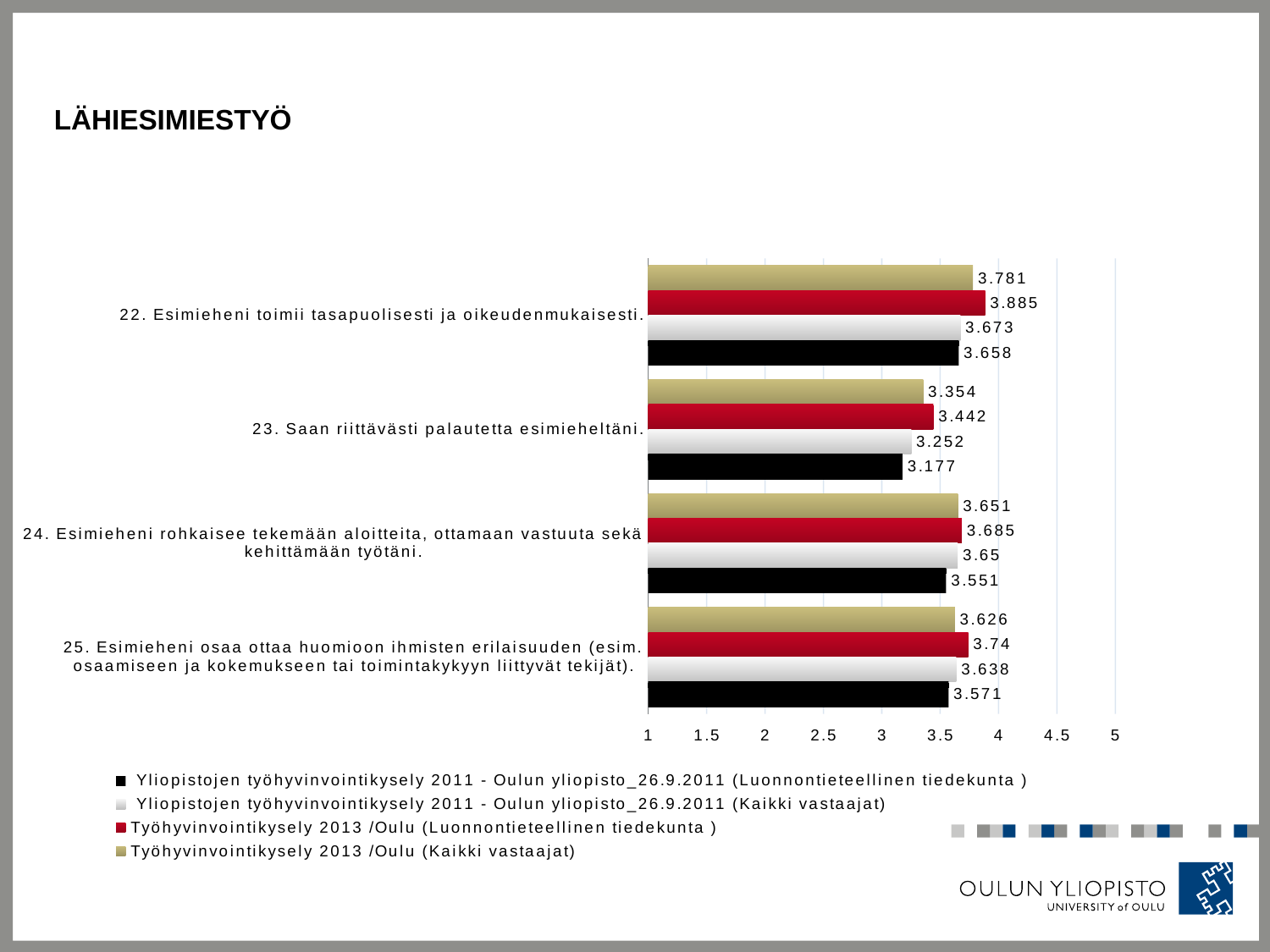
How many series does the legend list? 4 For question 25, which is larger: the Työhyvinvointikysely 2013 /Oulu (Luonnontieteellinen tiedekunta) value or the Yliopistojen työhyvinvointikysely 2011 (Kaikki vastaajat) value? Työhyvinvointikysely 2013 /Oulu (Luonnontieteellinen tiedekunta) What is the value for question 23 in the Yliopistojen työhyvinvointikysely 2011 (Luonnontieteellinen tiedekunta) series? 3.177 Which question has the highest value in the Työhyvinvointikysely 2013 /Oulu (Luonnontieteellinen tiedekunta) series? 22. Esimieheni toimii tasapuolisesti ja oikeudenmukaisesti. What is the value for question 25 in the Työhyvinvointikysely 2013 /Oulu (Kaikki vastaajat) series? 3.626 What is the value for question 22 in the Työhyvinvointikysely 2013 /Oulu (Luonnontieteellinen tiedekunta) series? 3.885 What is the difference between the 2013 Luonnontieteellinen tiedekunta value and the 2011 Luonnontieteellinen tiedekunta value for question 23? 0.265 What is the value for question 24 in the Yliopistojen työhyvinvointikysely 2011 (Kaikki vastaajat) series? 3.65 Which question has the lowest value in the Yliopistojen työhyvinvointikysely 2011 (Luonnontieteellinen tiedekunta) series? 23. Saan riittävästi palautetta esimieheltäni. How many questions (categories) are shown on the chart? 4 What kind of chart is shown on the slide? bar chart Is the value for question 23 in the Yliopistojen työhyvinvointikysely 2011 (Kaikki vastaajat) series greater or less than 3.5? less